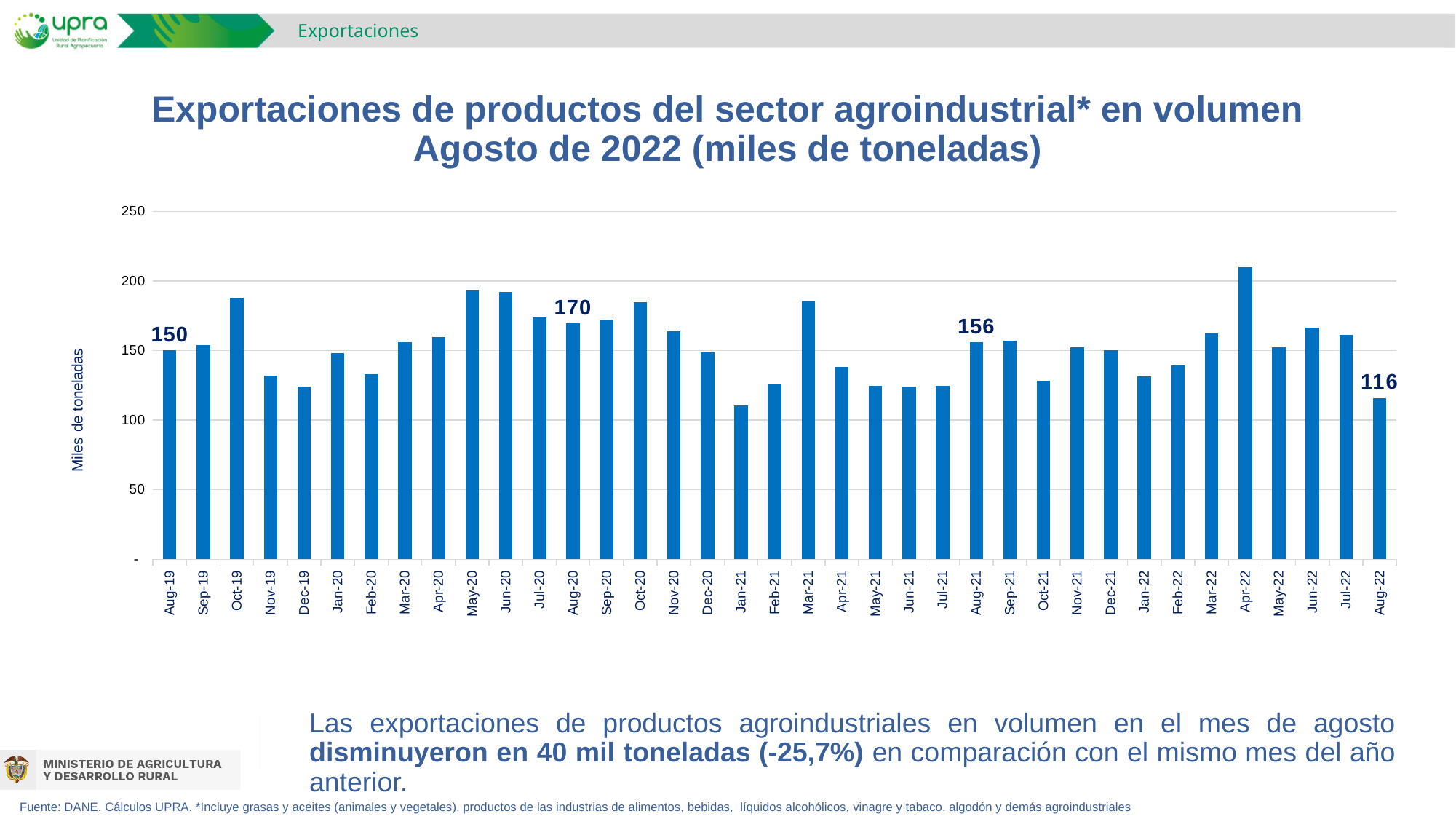
How many months (bars) are plotted in the chart? 37 What is the value for Aug-19? 150 Is the value for Dec-19 greater or less than 150? less Is the value for Oct-19 greater or less than 150? greater What is the label of the vertical axis? Miles de toneladas What is the value for Aug-22? 116 What is the value for Aug-21? 156 Which month has the highest bar in the chart? Apr-22 What is the value for Aug-20? 170 What is the difference between the values for Aug-21 and Aug-22? 40 What type of chart is shown on the slide? Bar chart Which is larger, the value for Aug-20 or the value for Aug-21? Aug-20